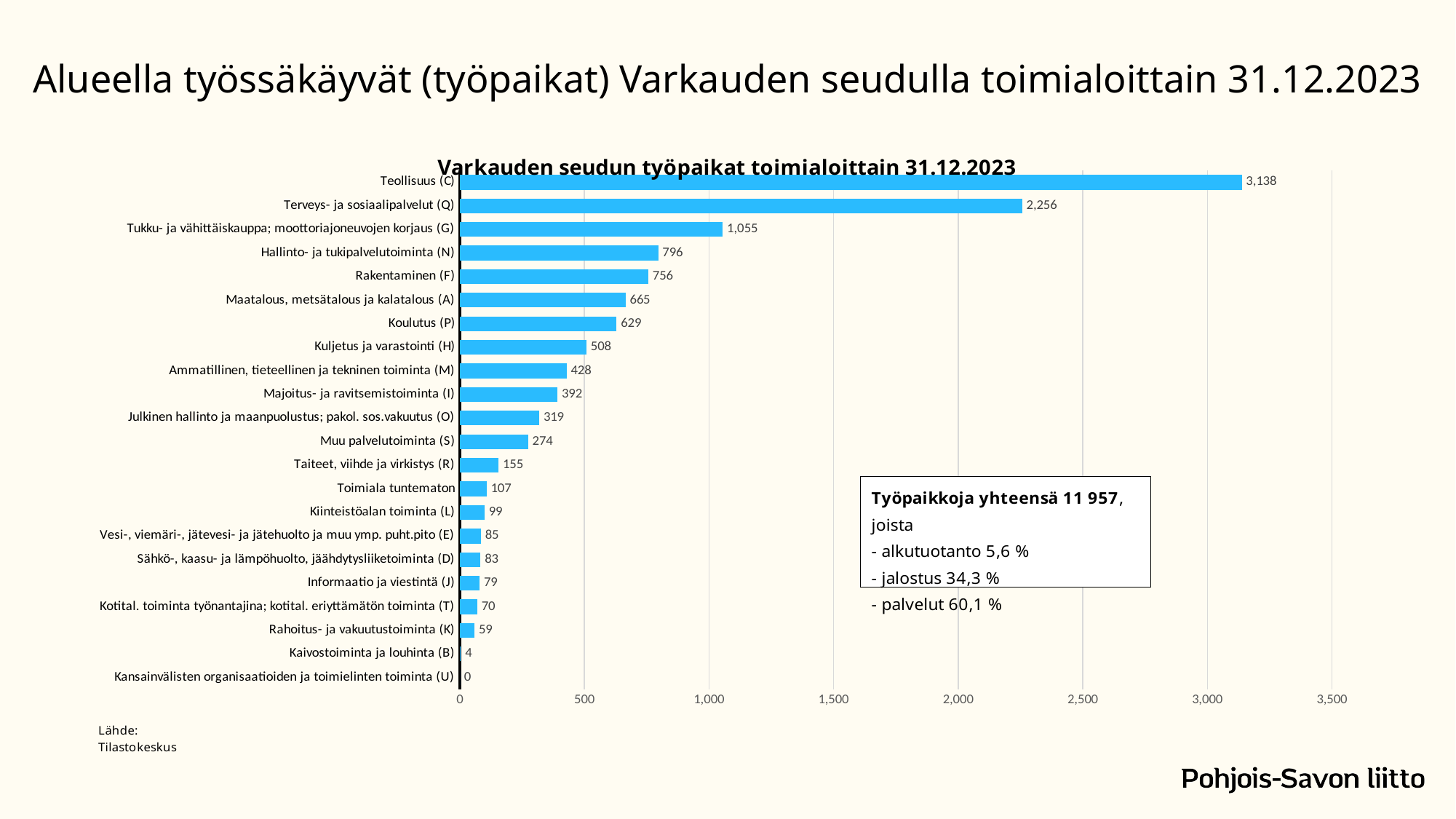
What is the difference between Teollisuus (C) and Terveys- ja sosiaalipalvelut (Q)? 882 Which is larger, Kuljetus ja varastointi (H) or Majoitus- ja ravitsemistoiminta (I)? Kuljetus ja varastointi (H) What is the value for Rakentaminen (F)? 756 What is the difference between Hallinto- ja tukipalvelutoiminta (N) and Rakentaminen (F)? 40 What is the value for Teollisuus (C)? 3,138 Which category has the lowest value? Kansainvälisten organisaatioiden ja toimielinten toiminta (U) What kind of chart is shown on the slide? Bar chart What is the value for Koulutus (P)? 629 How many categories are shown in the chart? 22 What is the title of the chart? Varkauden seudun työpaikat toimialoittain 31.12.2023 Which category has the highest value? Teollisuus (C) Is the value for Tukku- ja vähittäiskauppa; moottoriajoneuvojen korjaus (G) greater or less than 1,000? greater